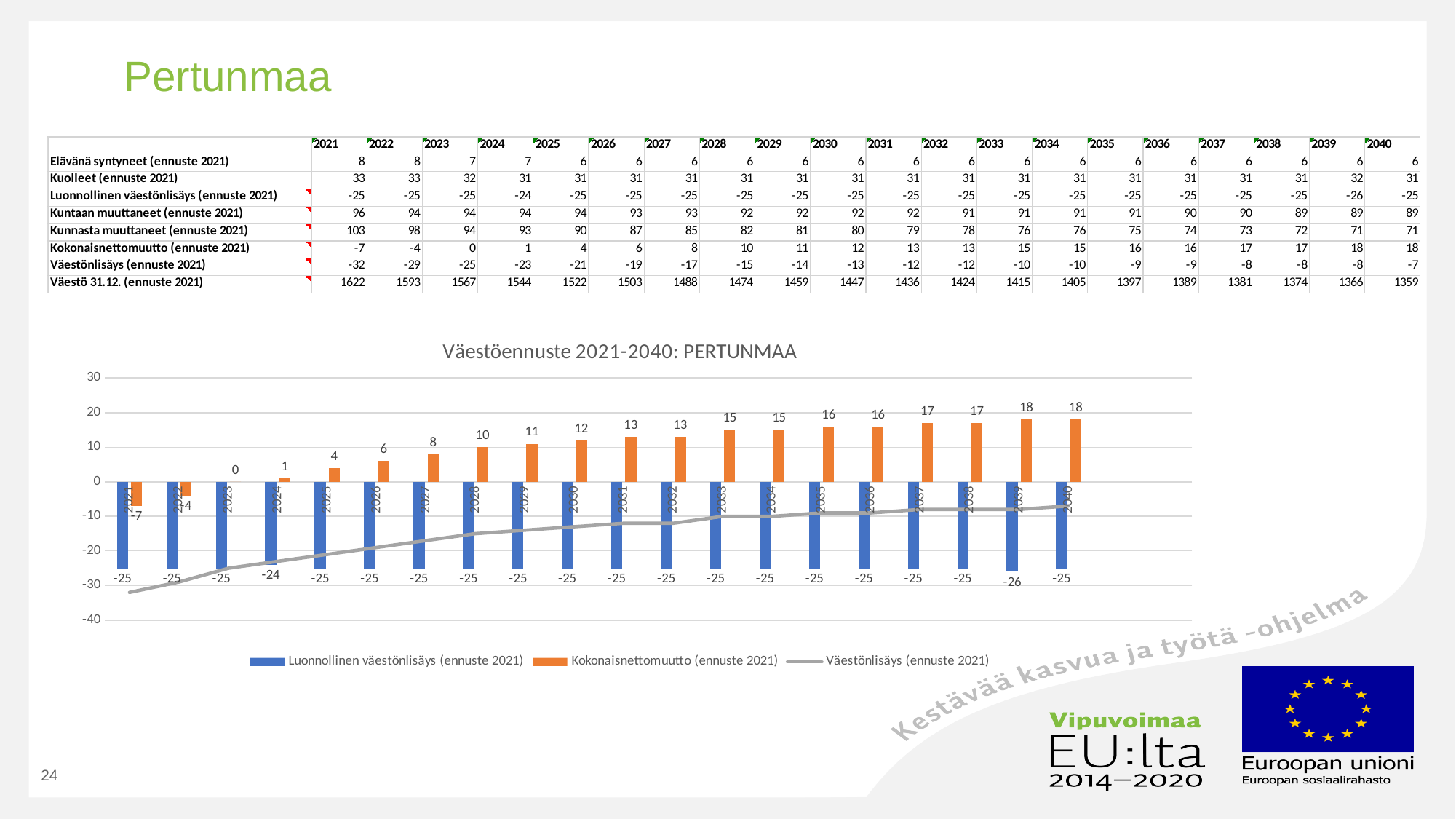
In which year does Kokonaisnettomuutto (ennuste 2021) first reach 18 in the chart? 2039 What is the difference between Kokonaisnettomuutto (ennuste 2021) in 2040 and in 2021? 25 What is the value of Kokonaisnettomuutto (ennuste 2021) for 2021 in the chart? -7 Is the Väestönlisäys (ennuste 2021) line value for 2021 greater or less than -30? less What type of chart is shown under the title 'Väestöennuste 2021-2040: PERTUNMAA'? Bar chart with a line What is the value of Luonnollinen väestönlisäys (ennuste 2021) for 2024 in the chart? -24 What is the value of Kokonaisnettomuutto (ennuste 2021) for 2040 in the chart? 18 In which year is Luonnollinen väestönlisäys (ennuste 2021) lowest in the chart? 2039 How many series does the legend of the chart list? 3 How many years are plotted on the x axis of the chart? 20 Which is larger in 2030: Kokonaisnettomuutto (ennuste 2021) or Luonnollinen väestönlisäys (ennuste 2021)? Kokonaisnettomuutto (ennuste 2021) Does Kokonaisnettomuutto (ennuste 2021) rise or fall from 2021 to 2040 in the chart? Rise